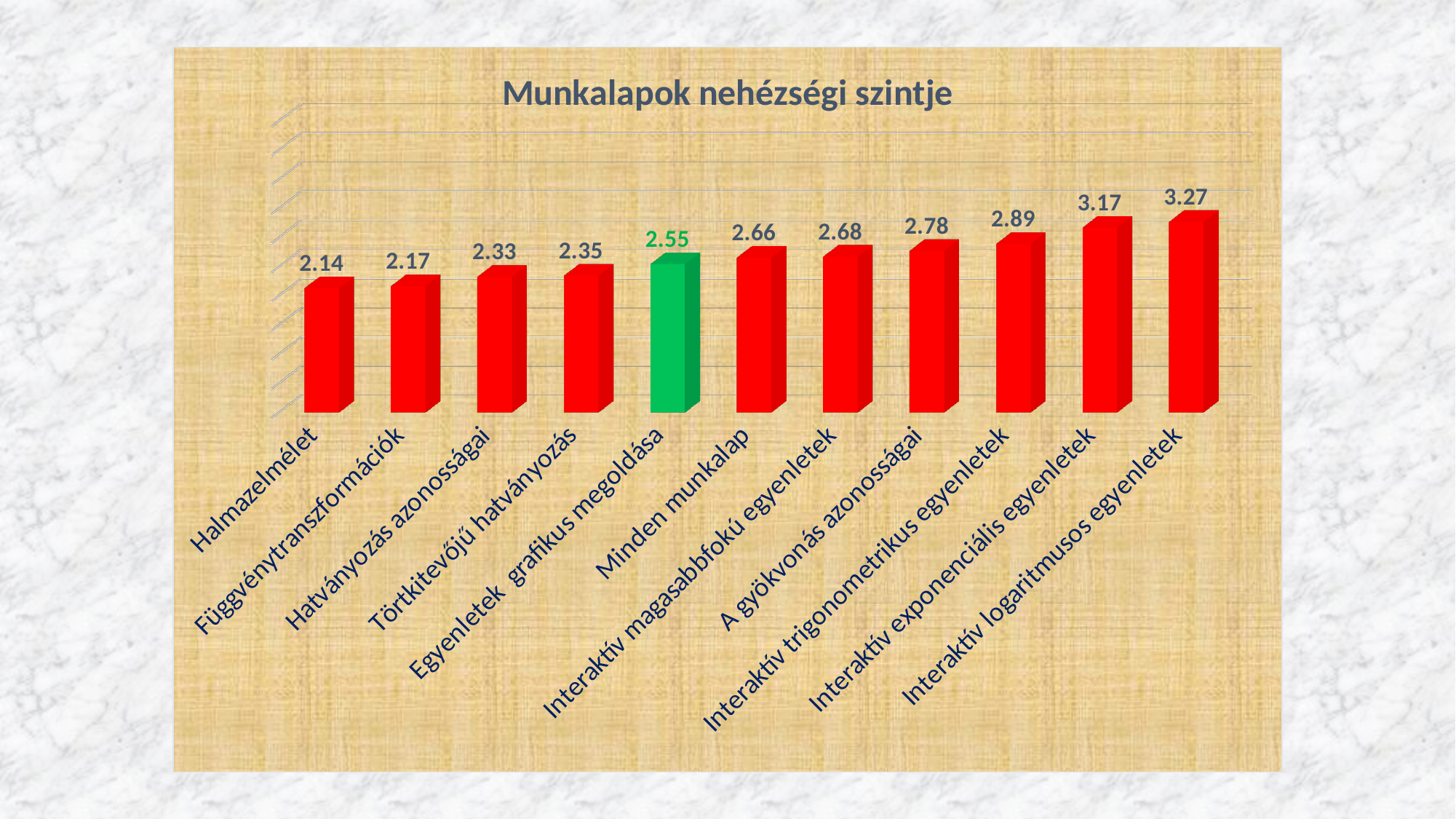
Which category has the lowest value? Halmazelmélet What is the difference between the values for Interaktív exponenciális egyenletek and Minden munkalap? 0.51 Which category has the highest value? Interaktív logaritmusos egyenletek What is the value for Egyenletek grafikus megoldása? 2.55 What is the title of the chart? Munkalapok nehézségi szintje What is the value for Halmazelmélet? 2.14 What is the difference between the values for Interaktív logaritmusos egyenletek and Halmazelmélet? 1.13 How many categories are shown in the chart? 11 Which is larger, the value for A gyökvonás azonosságai or the value for Hatványozás azonosságai? A gyökvonás azonosságai What kind of chart is shown on the slide? Bar chart Do the values rise or fall from left to right along the x axis? Rise What is the value for Interaktív trigonometrikus egyenletek? 2.89